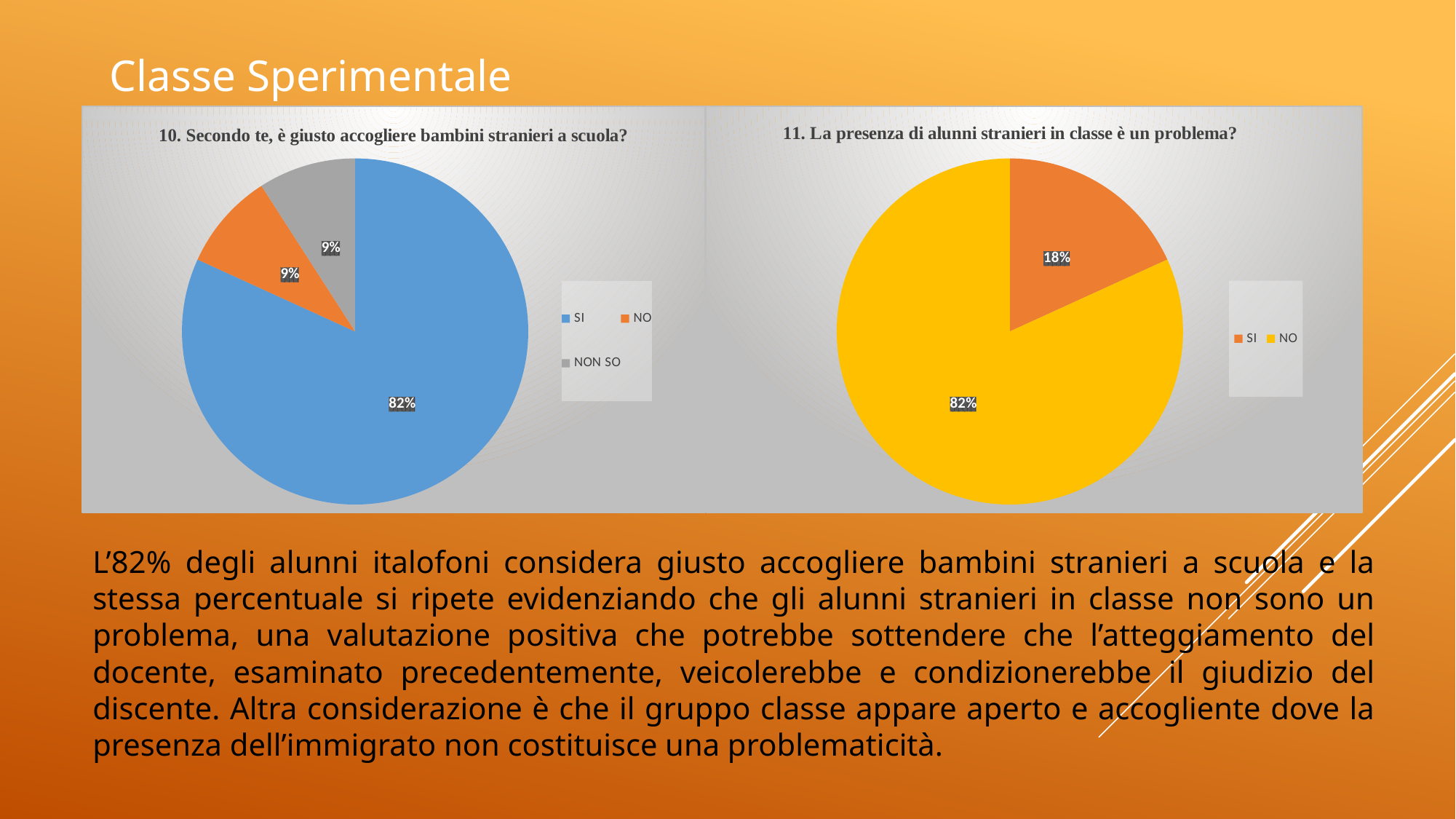
In the left chart (question 10), what share of responses is NON SO? 9% In the left chart (question 10), what is the difference between the SI share and the NO share? 73% In the right chart (question 11), which colour represents NO? Yellow In the right chart (question 11), what share of responses is NO? 82% In the left chart (question 10), what share of responses is SI? 82% In the right chart (question 11), what share of responses is SI? 18% In the right chart (question 11), which category has the smallest share? SI In the left chart (question 10), how many categories does the legend list? 3 In the left chart (question 10), which category has the largest share? SI What kind of chart is the left chart (question 10)? Pie chart In the right chart (question 11), how many categories does the legend list? 2 In the right chart (question 11), what is the difference between the NO share and the SI share? 64%